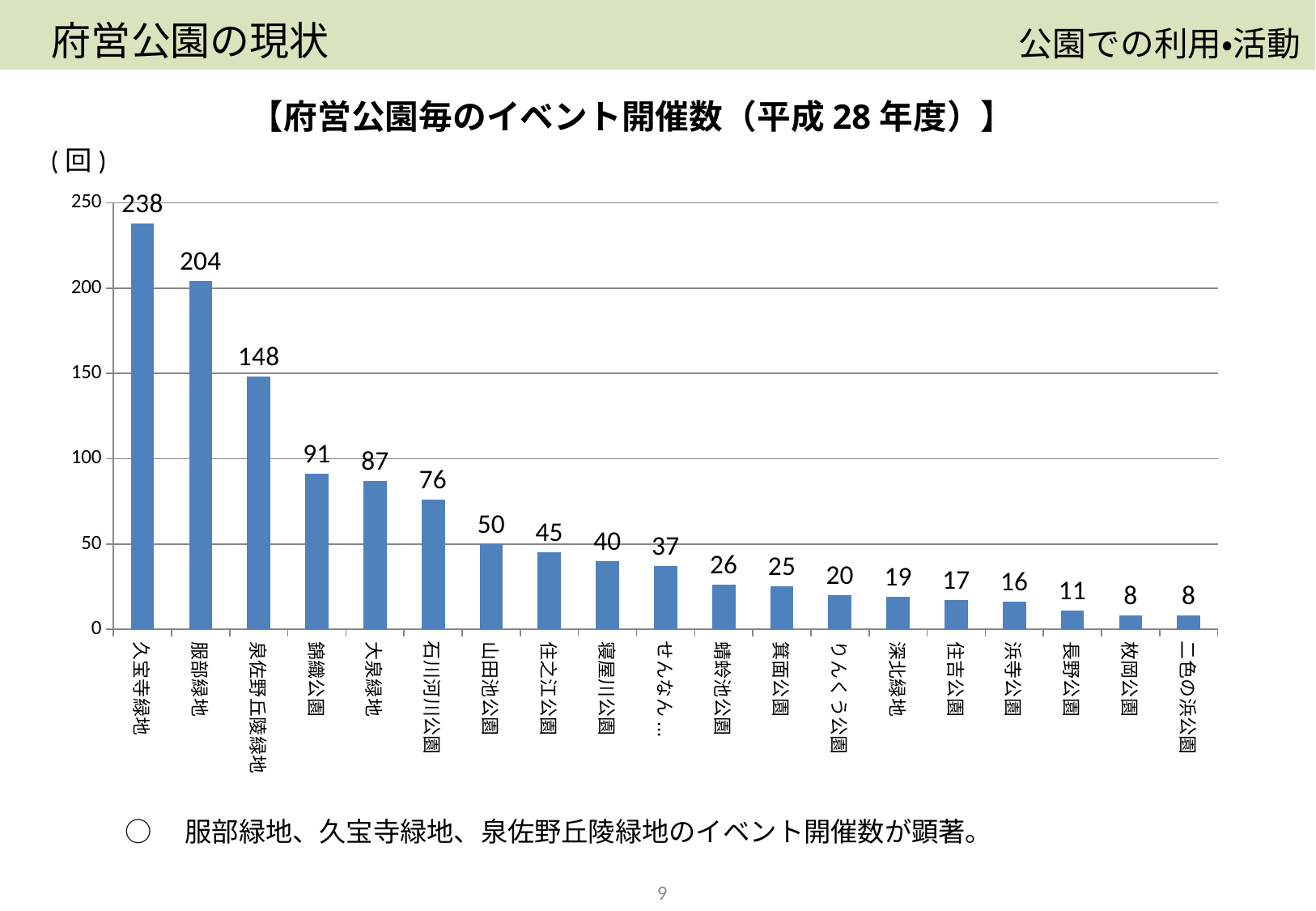
石川河川公園のイベント開催数は100回より多いですか、少ないですか？ 少ない グラフのタイトルは何ですか？ 府営公園毎のイベント開催数（平成28年度） 左から右へ見ると、イベント開催数は増加していますか、減少していますか？ 減少 久宝寺緑地のイベント開催数は何回ですか？ 238 りんくう公園のイベント開催数は何回ですか？ 20 山田池公園のイベント開催数は何回ですか？ 50 これはどの種類のグラフですか？ 棒グラフ 泉佐野丘陵緑地のイベント開催数は何回ですか？ 148 グラフには何か所の公園が示されていますか？ 19 錦織公園と大泉緑地では、どちらのイベント開催数が多いですか？ 錦織公園 イベント開催数が最も多い公園はどこですか？ 久宝寺緑地 久宝寺緑地と服部緑地のイベント開催数の差は何回ですか？ 34